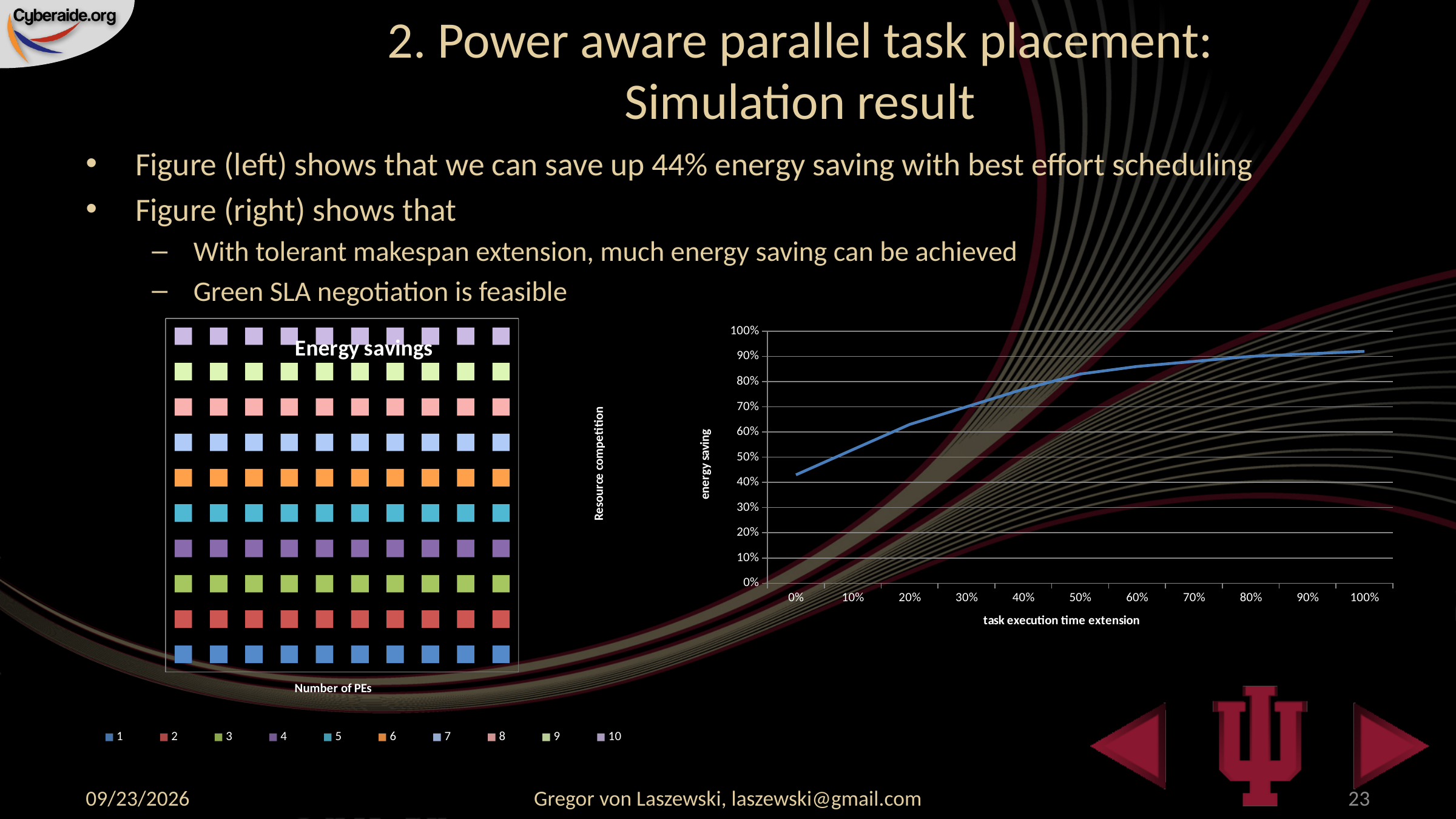
In the right-hand chart, is the energy saving at 0% task execution time extension greater or less than 40%? greater What is the x-axis label of the right-hand chart? task execution time extension In the right-hand chart, what is the highest value shown on the y-axis? 100% What is the title of the left-hand chart? Energy savings In the right-hand chart, does energy saving rise or fall as task execution time extension increases? rise In the right-hand chart, which has the higher energy saving: 10% or 60% task execution time extension? 60% In the right-hand chart, is the energy saving at 50% task execution time extension greater or less than 70%? greater How many series does the legend of the left-hand chart list? 10 In the right-hand chart, is the energy saving at 0% task execution time extension greater or less than 50%? less What kind of chart is the right-hand chart (energy saving vs task execution time extension)? line chart